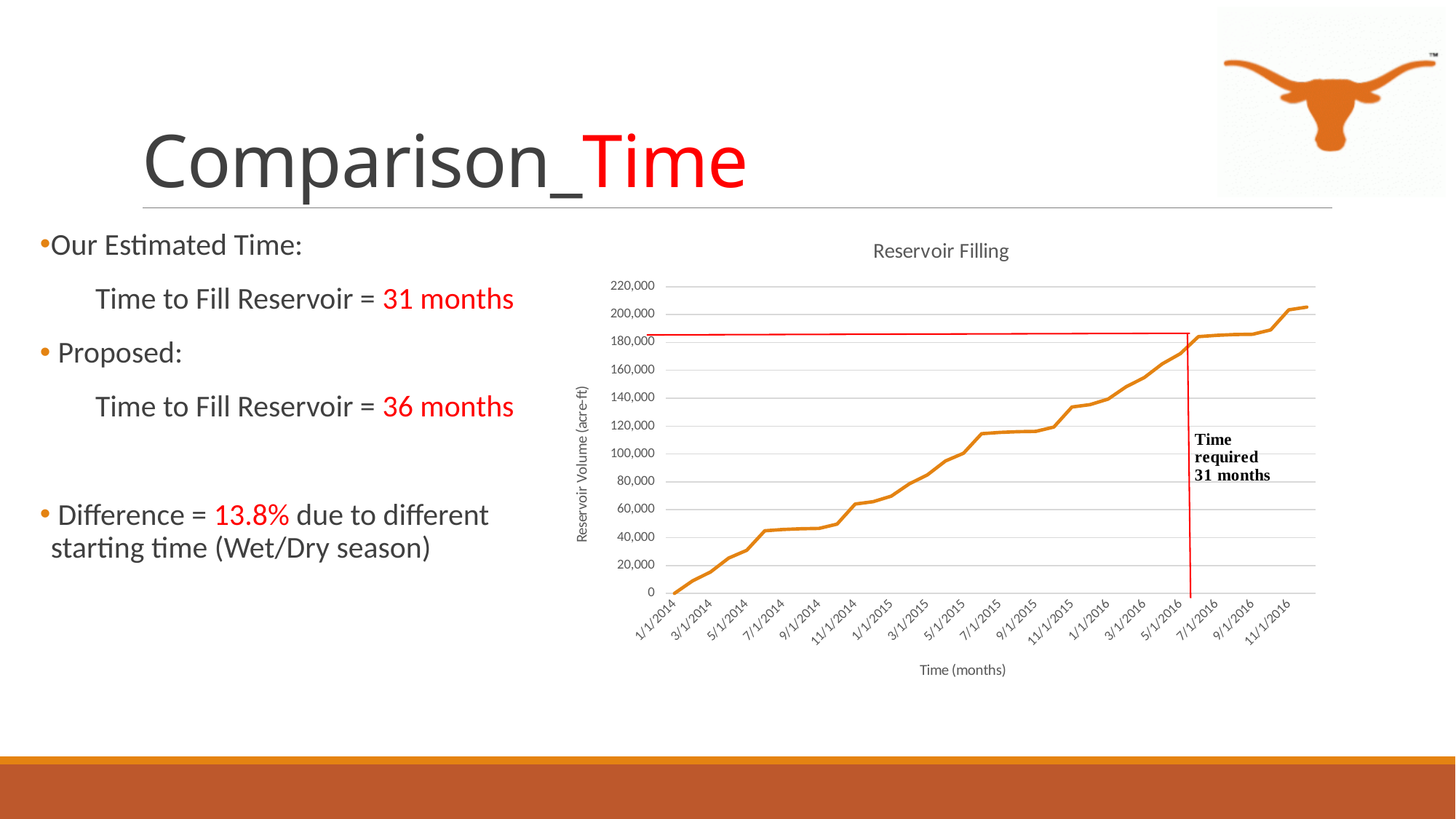
What is the title of the chart? Reservoir Filling What kind of chart is shown on the slide? line chart Which is larger, the reservoir volume at 5/1/2015 or at 5/1/2016? 5/1/2016 At which date on the x axis is the reservoir volume lowest? 1/1/2014 What is the label of the vertical axis of the chart? Reservoir Volume (acre-ft) Is the reservoir volume at 7/1/2015 greater or less than 100,000? greater Is the reservoir volume at 3/1/2014 greater or less than 20,000? less Is the reservoir volume at 9/1/2014 greater or less than 60,000? less How many date labels are shown along the x axis of the chart? 18 Does the reservoir volume rise or fall over time along the x axis? rise